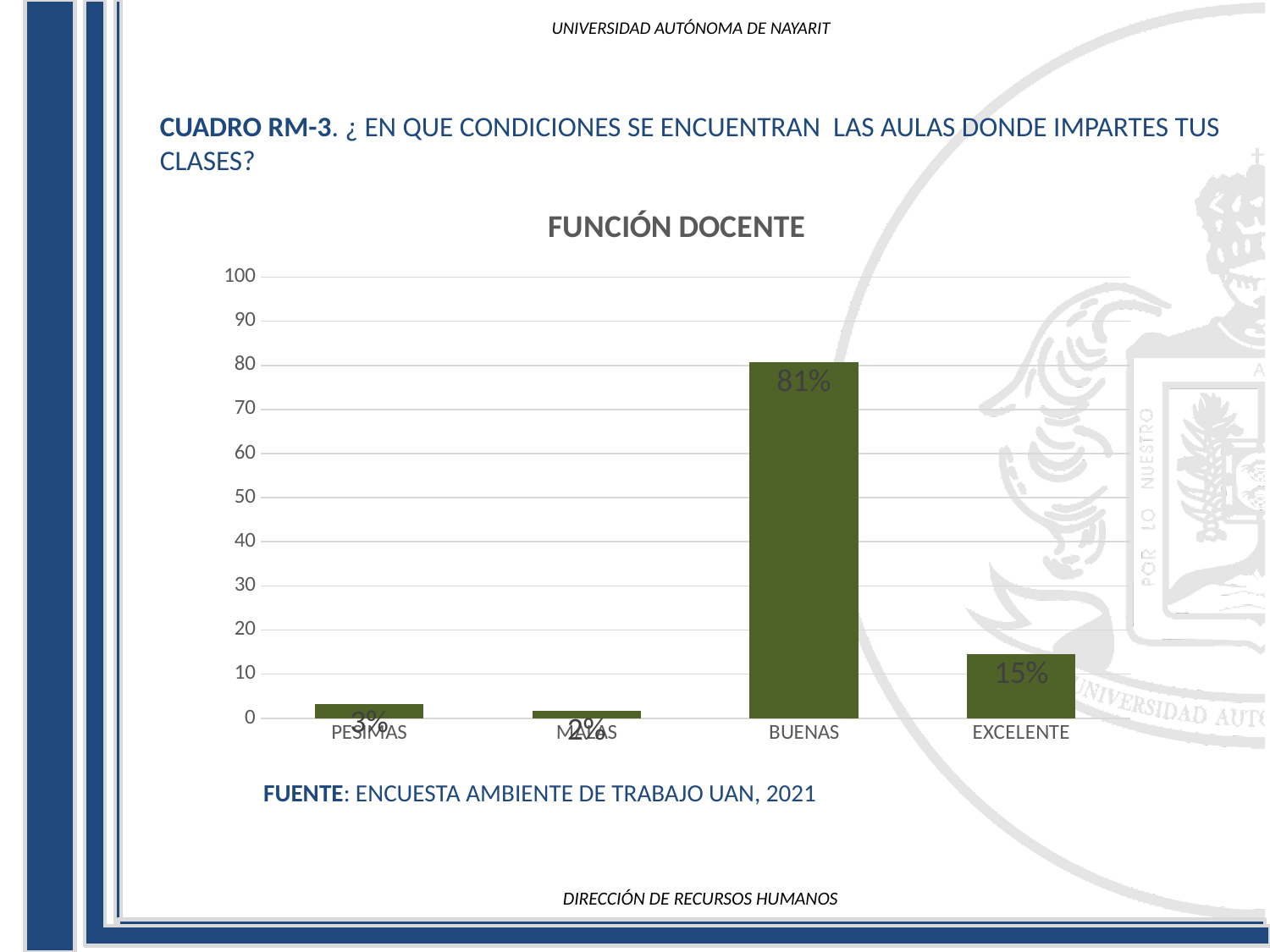
Which category has the lowest value? MALAS How many categories are shown on the x axis? 4 Which category has the highest value? BUENAS What is the value for MALAS? 2% What is the title of the chart? FUNCIÓN DOCENTE What is the value for BUENAS? 81% What is the difference between the values for BUENAS and EXCELENTE? 66% Is the value for BUENAS greater or less than 70? greater What is the value for EXCELENTE? 15% What is the value for PÉSIMAS? 3% What kind of chart is shown on the slide? bar chart Which is larger, the value for EXCELENTE or the value for PÉSIMAS? EXCELENTE